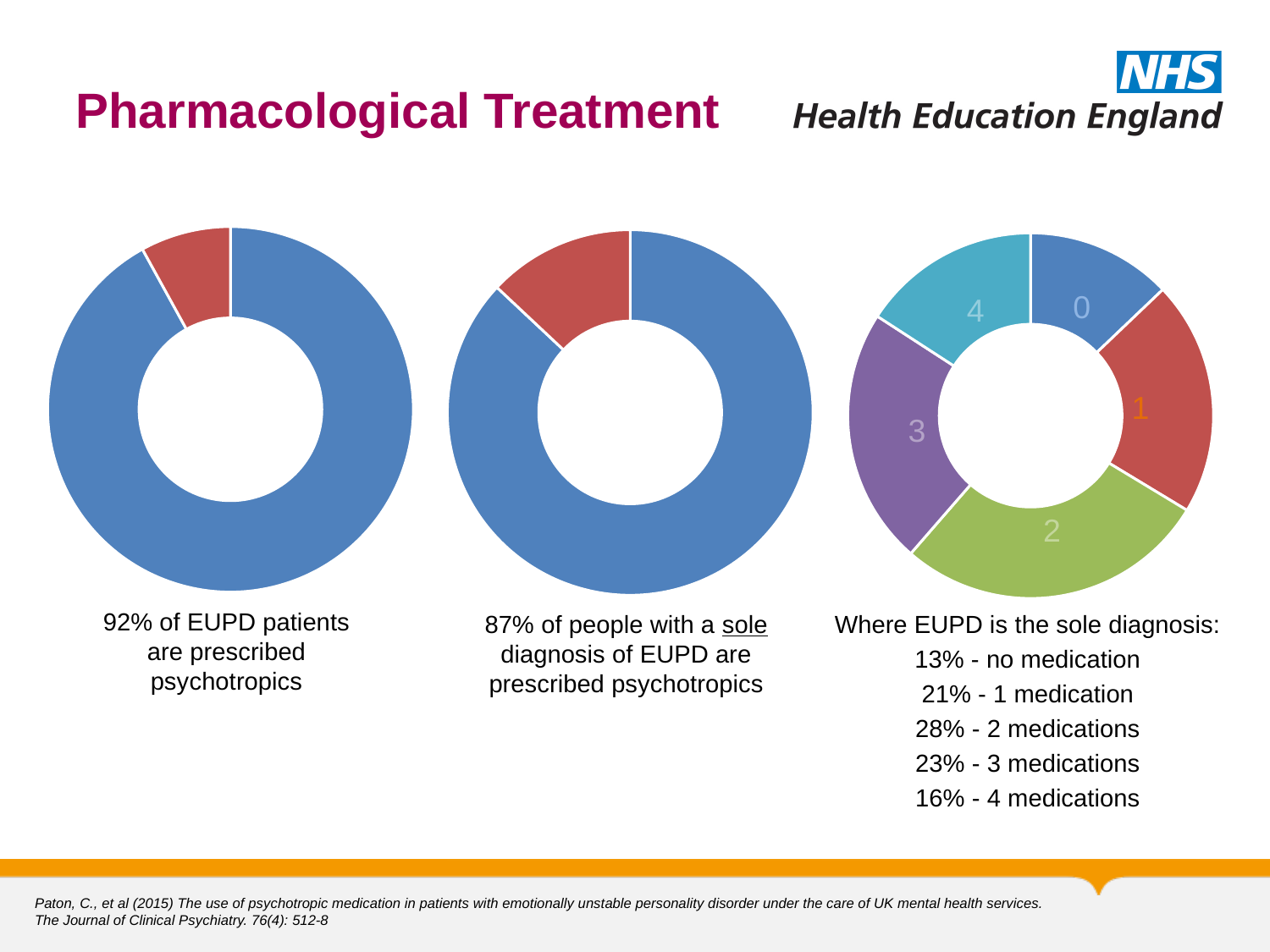
In the right chart (where EUPD is the sole diagnosis), what share of patients are on 2 medications? 28% In the right chart (where EUPD is the sole diagnosis), how many slices does the doughnut have? 5 In the right chart (where EUPD is the sole diagnosis), what share of patients are on 4 medications? 16% In the right chart (where EUPD is the sole diagnosis), which number of medications has the largest share? 2 medications In the right chart (where EUPD is the sole diagnosis), what share of patients are on no medication? 13% What kind of chart is used for the three charts on the slide? Doughnut chart In the middle chart, what share of people with a sole diagnosis of EUPD are prescribed psychotropics? 87% How many doughnut charts are shown on the slide? 3 In the right chart (where EUPD is the sole diagnosis), which is larger: the share on 1 medication or the share on 4 medications? 1 medication In the left chart, what share of EUPD patients are prescribed psychotropics? 92% In the right chart (where EUPD is the sole diagnosis), which number of medications has the smallest share? No medication In the right chart (where EUPD is the sole diagnosis), what is the difference between the share on 3 medications and the share on 1 medication? 2%